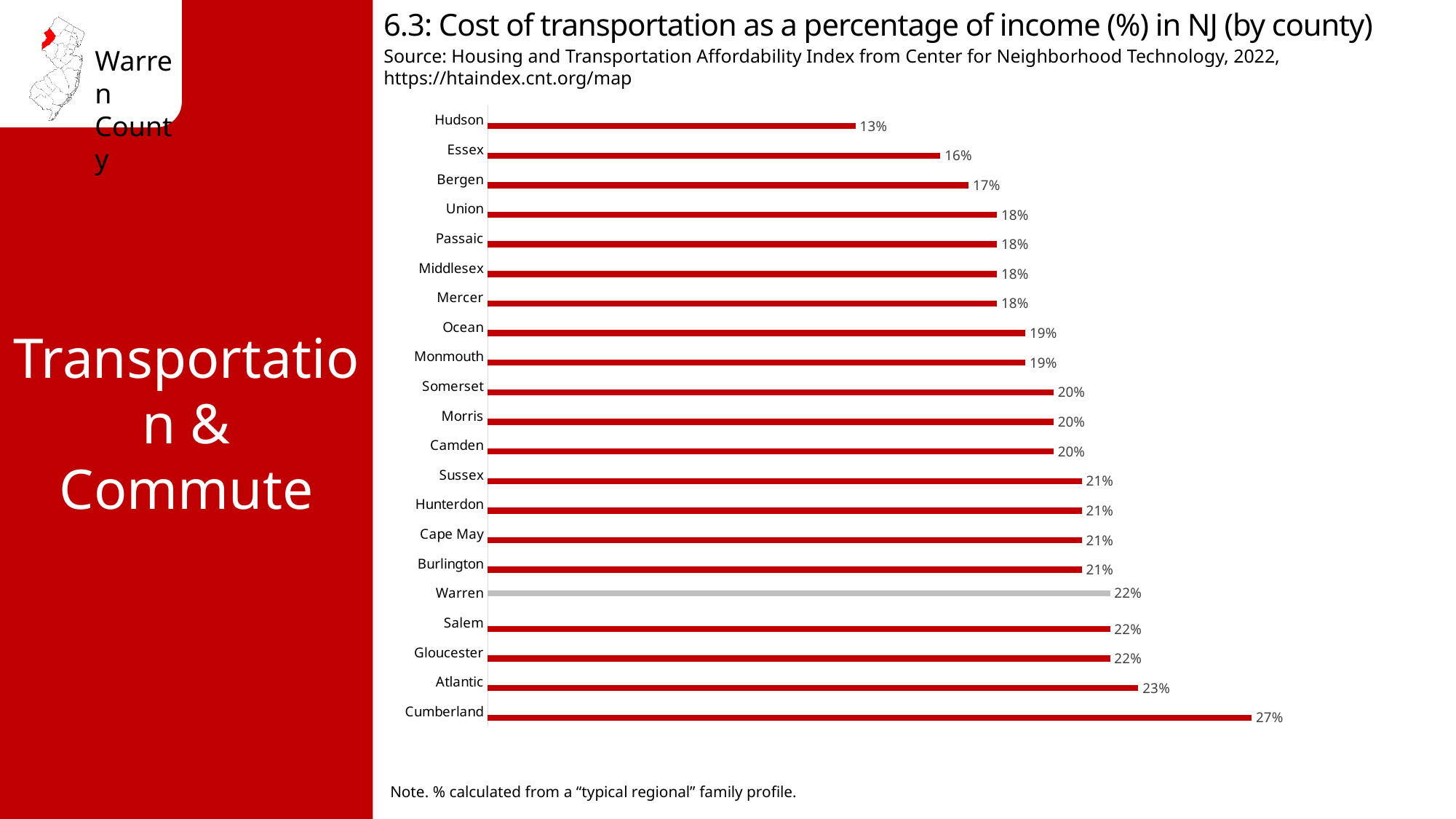
What is the value shown for Cumberland County? 27% Which county has the highest cost of transportation as a percentage of income? Cumberland How many counties are shown in the chart? 21 What type of chart is used on this slide? Bar chart Which has a higher value, Essex or Atlantic? Atlantic What is the cost of transportation as a percentage of income for Warren County? 22% What is the difference in percentage points between Cumberland and Hudson? 14 What is the difference in percentage points between Warren and Bergen? 5 What is the value shown for Atlantic County? 23% Which county has the lowest cost of transportation as a percentage of income? Hudson Which county's bar is shown in grey rather than red? Warren What is the cost of transportation as a percentage of income for Hudson County? 13%